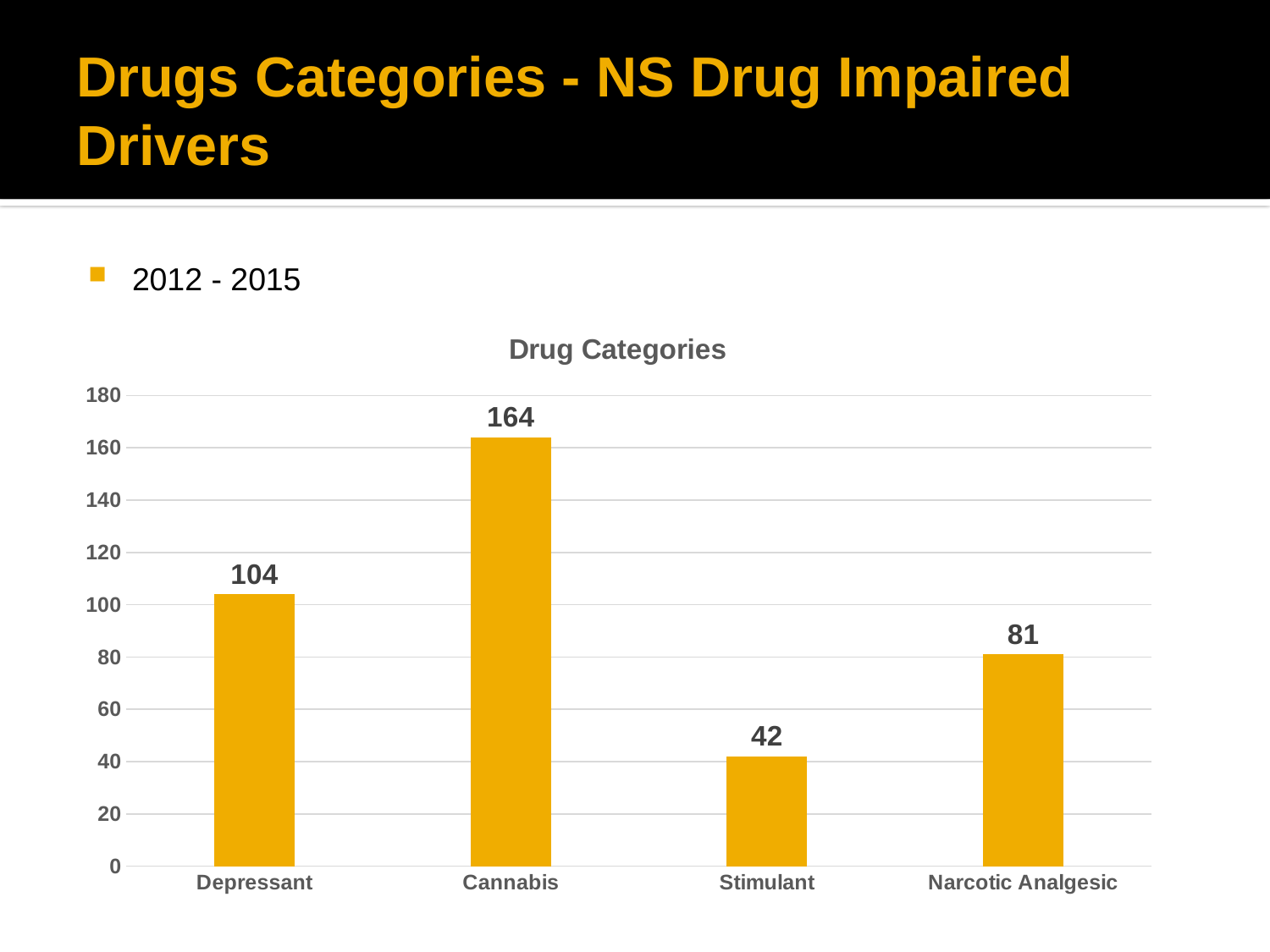
Which drug category has the lowest value? Stimulant Which is larger, the value for Depressant or the value for Narcotic Analgesic? Depressant What is the value for Depressant? 104 Which drug category has the highest value? Cannabis How many drug categories are shown in the chart? 4 What is the title of the chart? Drug Categories What is the value for Cannabis? 164 What kind of chart is shown on the slide? Bar chart What is the value for Stimulant? 42 What is the difference between the values for Narcotic Analgesic and Stimulant? 39 What is the value for Narcotic Analgesic? 81 What is the difference between the values for Cannabis and Depressant? 60